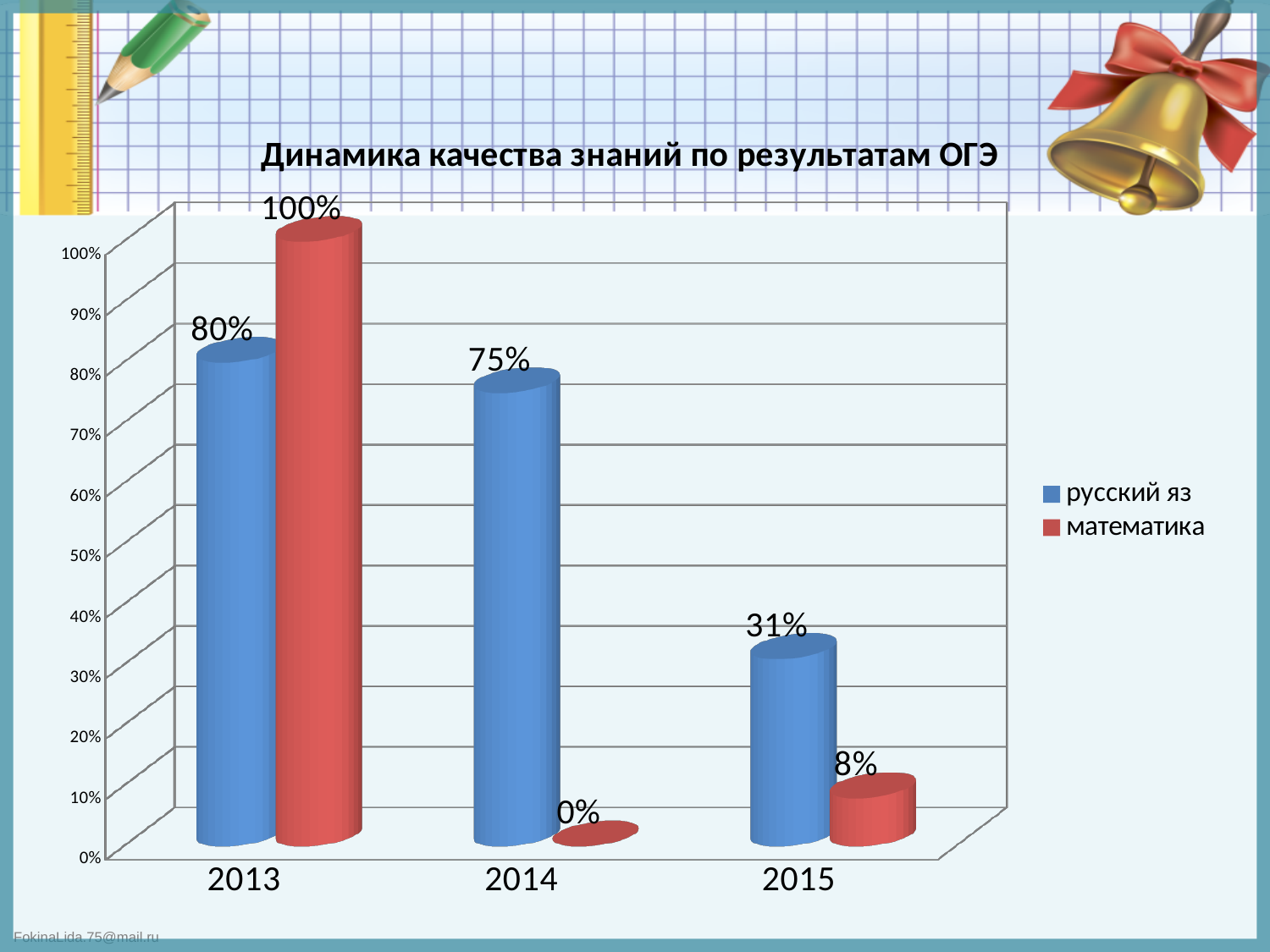
What is the value for русский яз in 2013? 80% Which is larger in 2013, русский яз or математика? математика How many series does the legend list? 2 Which year has the highest value for русский яз? 2013 What is the value for русский яз in 2014? 75% What kind of chart is this? bar chart What is the value for математика in 2013? 100% What is the difference between русский яз and математика in 2015? 23% What is the value for математика in 2015? 8% Which year has the lowest value for математика? 2014 How many years are shown on the x axis? 3 Do the values for русский яз rise or fall from 2013 to 2015? fall